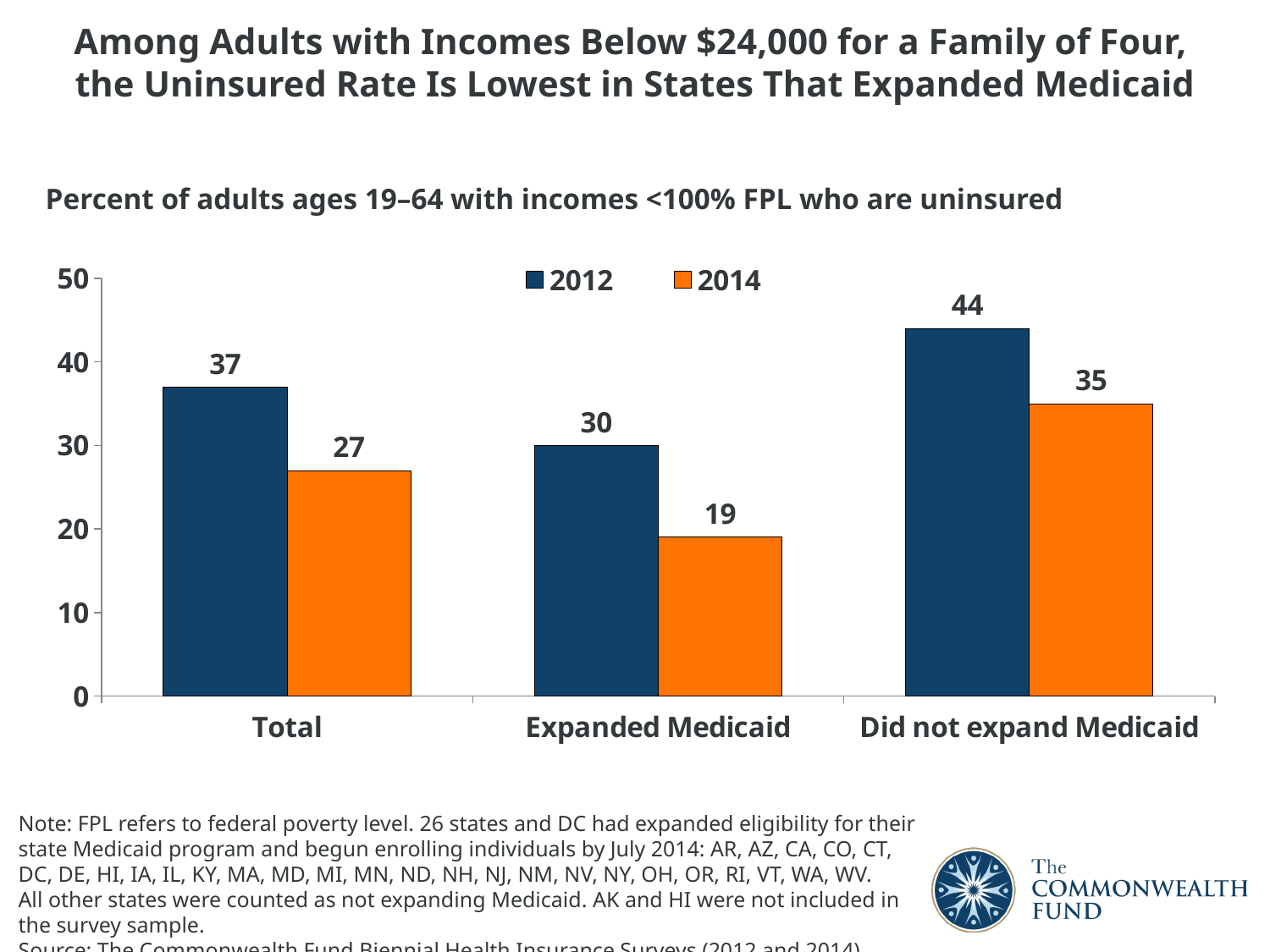
Which is larger, the 2014 value for Total or the 2012 value for Expanded Medicaid? 2012 value for Expanded Medicaid What kind of chart is shown? Bar chart What is the difference between the 2014 values for Did not expand Medicaid and Expanded Medicaid? 16 Which colour represents the 2014 series? Orange What is the difference between the 2012 and 2014 values for Expanded Medicaid? 11 What is the 2012 value for Did not expand Medicaid? 44 Which category has the highest 2014 value? Did not expand Medicaid What is the 2014 value for Expanded Medicaid? 19 What is the 2012 value for Total? 37 How many series does the legend list? 2 Which category has the lowest 2012 value? Expanded Medicaid How many categories are shown on the x axis? 3